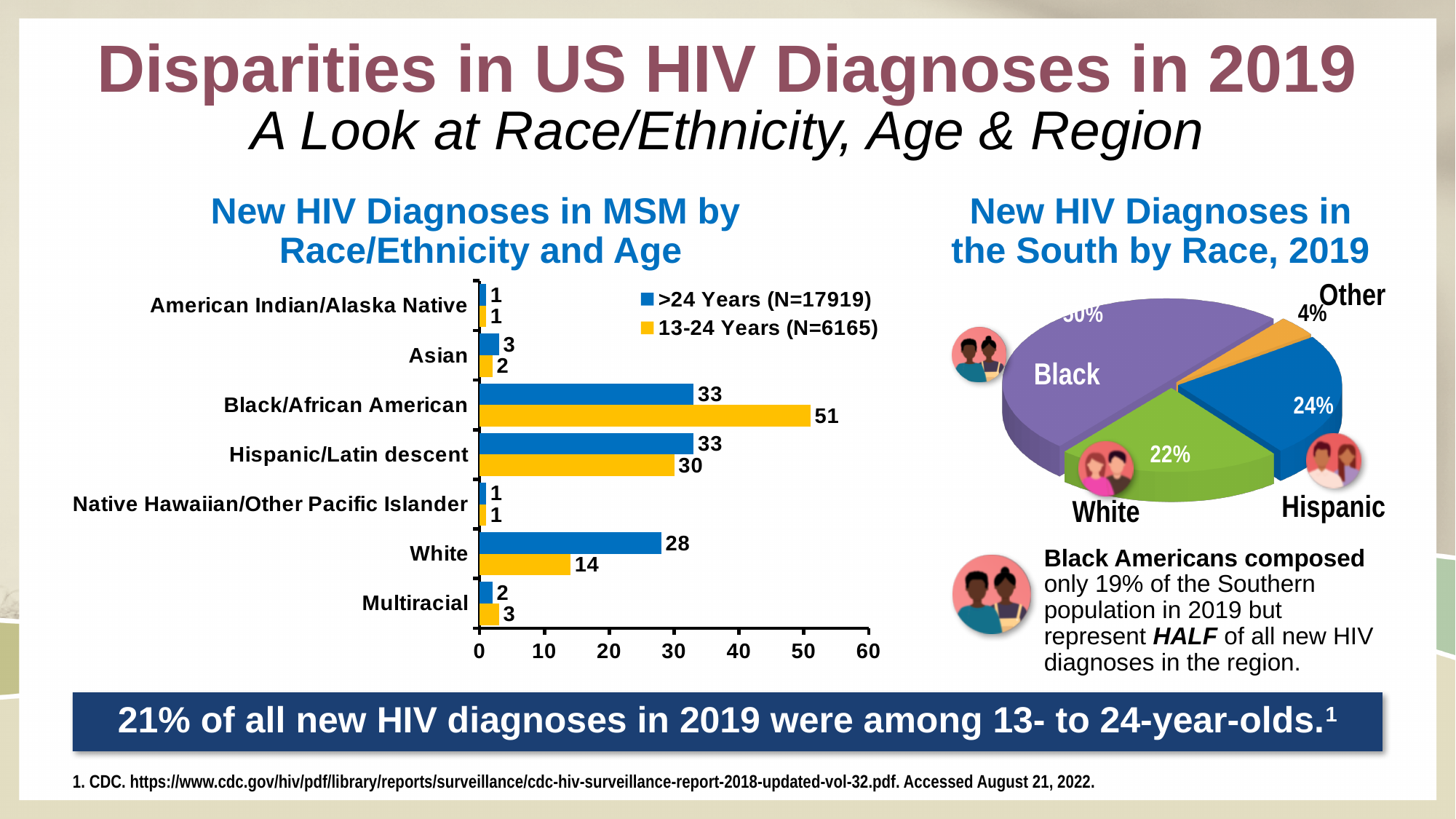
In the 'New HIV Diagnoses in MSM by Race/Ethnicity and Age' chart, what is the value for White in the >24 Years series? 28 In the 'New HIV Diagnoses in the South by Race, 2019' pie chart, what share is Hispanic? 24% What kind of chart is 'New HIV Diagnoses in MSM by Race/Ethnicity and Age'? Bar chart In the 'New HIV Diagnoses in MSM by Race/Ethnicity and Age' chart, what is the value for Black/African American in the 13-24 Years series? 51 In the 'New HIV Diagnoses in MSM by Race/Ethnicity and Age' chart, what is the value for Hispanic/Latin descent in the 13-24 Years series? 30 In the 'New HIV Diagnoses in MSM by Race/Ethnicity and Age' chart, how many series does the legend list? 2 In the 'New HIV Diagnoses in MSM by Race/Ethnicity and Age' chart, which race/ethnicity has the highest value in the 13-24 Years series? Black/African American In the 'New HIV Diagnoses in the South by Race, 2019' pie chart, what share is Other? 4% In the 'New HIV Diagnoses in the South by Race, 2019' pie chart, which race has the largest slice? Black In the 'New HIV Diagnoses in MSM by Race/Ethnicity and Age' chart, which is larger for White: the >24 Years value or the 13-24 Years value? >24 Years In the 'New HIV Diagnoses in MSM by Race/Ethnicity and Age' chart, what is the difference between the 13-24 Years and >24 Years values for Black/African American? 18 In the 'New HIV Diagnoses in MSM by Race/Ethnicity and Age' chart, how many race/ethnicity categories are shown? 7